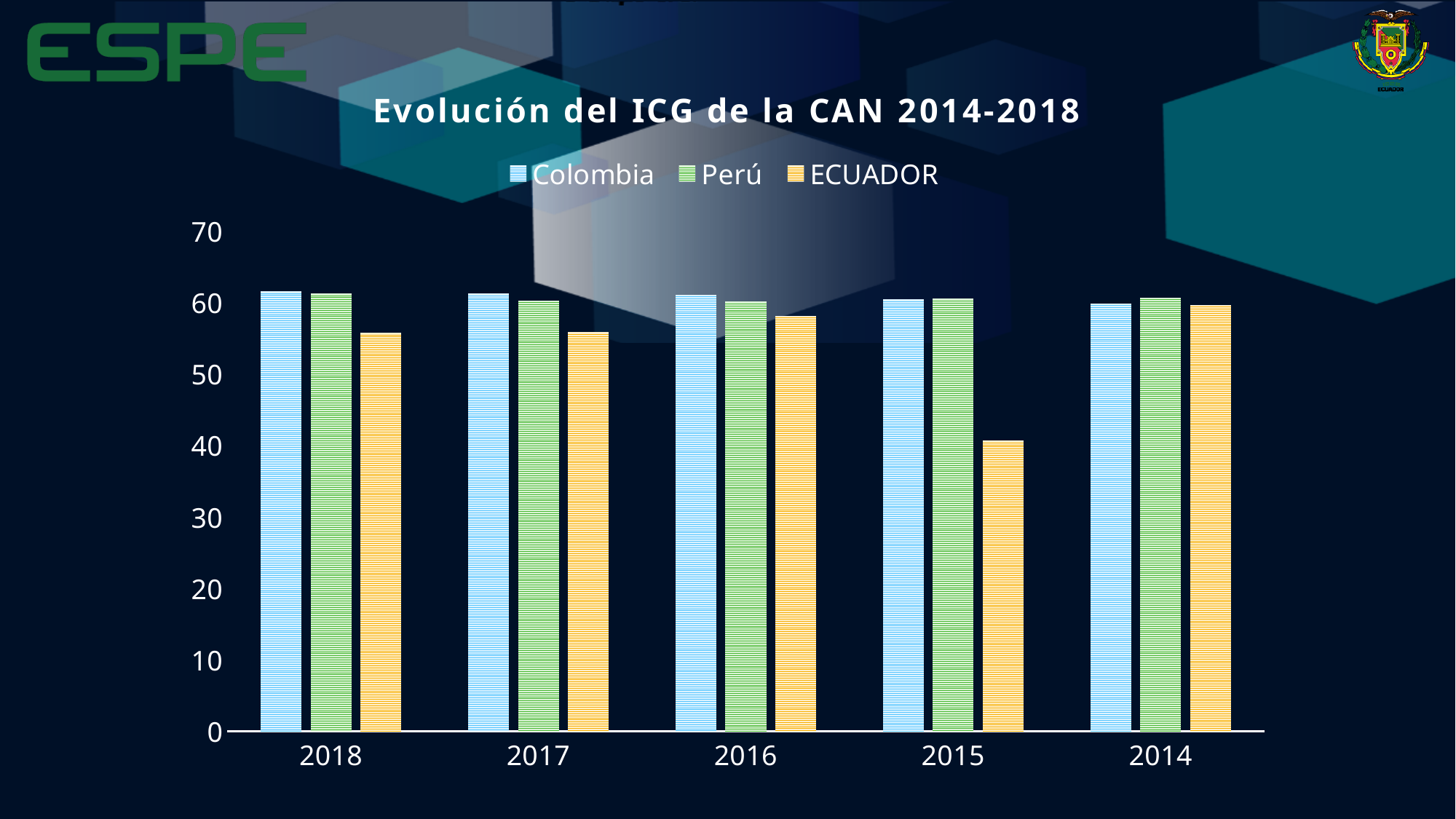
Which is larger in 2018, the Colombia value or the ECUADOR value? Colombia What kind of chart is shown on the slide? bar chart Which series is shown in orange/yellow in the legend? ECUADOR Which series has the lowest value in 2015? ECUADOR How many years are shown on the x axis? 5 Is the ECUADOR value for 2018 greater or less than 60? less How many series does the legend list? 3 Which is larger, the ECUADOR value for 2014 or the ECUADOR value for 2015? 2014 Is the Colombia value for 2017 greater or less than 50? greater In which year is the ECUADOR value lowest? 2015 What is the title of the chart? Evolución del ICG de la CAN 2014-2018 Is the ECUADOR value for 2015 greater or less than 50? less